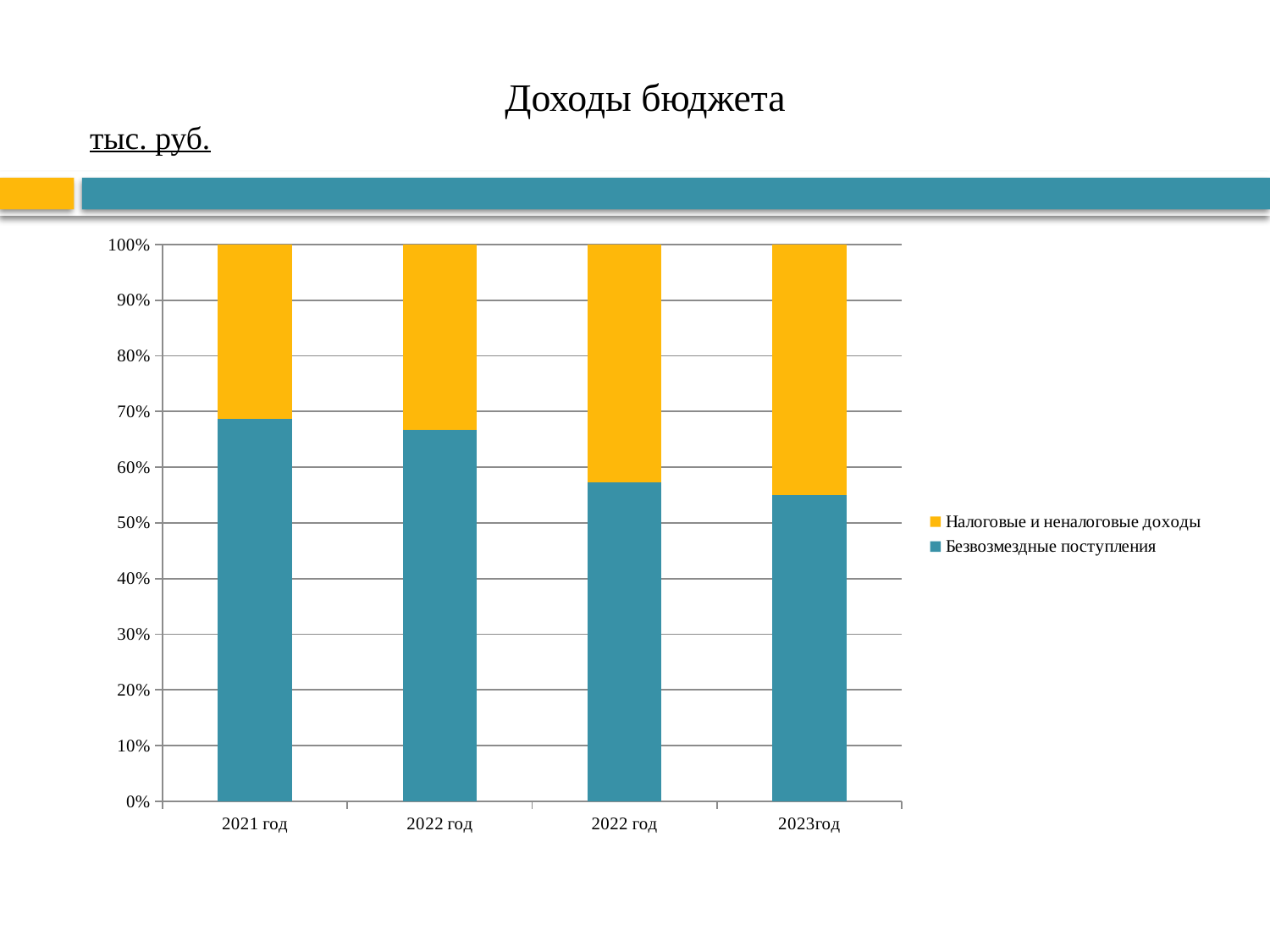
What kind of chart is shown on the slide? Stacked bar chart How many bars (categories) are plotted on the x axis? 4 Is the share of Безвозмездные поступления for 2023год greater or less than 60%? less Which is larger, the share of Безвозмездные поступления for 2021 год or for 2023год? 2021 год Is the share of Безвозмездные поступления for 2021 год greater or less than 70%? less Is the share of Безвозмездные поступления for 2021 год greater or less than 60%? greater Which series is shown in yellow according to the legend? Налоговые и неналоговые доходы How many series does the legend list? 2 Does the share of Безвозмездные поступления rise or fall from left to right along the x axis? Fall What is the title of the chart? Доходы бюджета